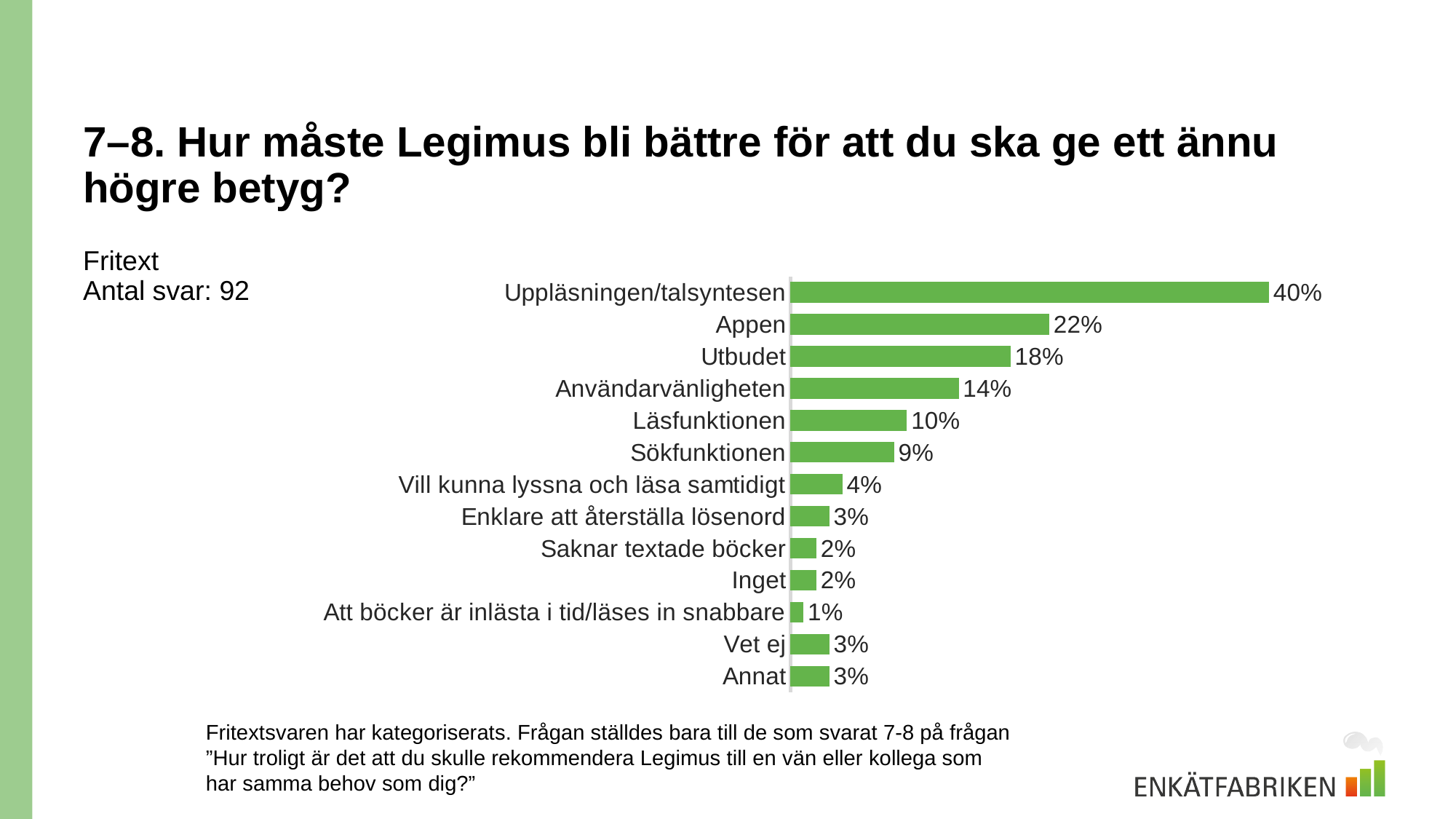
Which is larger, the value for Utbudet or the value for Användarvänligheten? Utbudet What is the difference between the values for Uppläsningen/talsyntesen and Appen? 18% Which category has the highest value? Uppläsningen/talsyntesen What is the difference between the values for Utbudet and Läsfunktionen? 8% What kind of chart is shown on the slide? Bar chart What is the value for Appen? 22% What is the value for Användarvänligheten? 14% Which category has the lowest value? Att böcker är inlästa i tid/läses in snabbare What is the value for Uppläsningen/talsyntesen? 40% How many categories are shown in the chart? 13 What is the value for Att böcker är inlästa i tid/läses in snabbare? 1% What is the value for Sökfunktionen? 9%